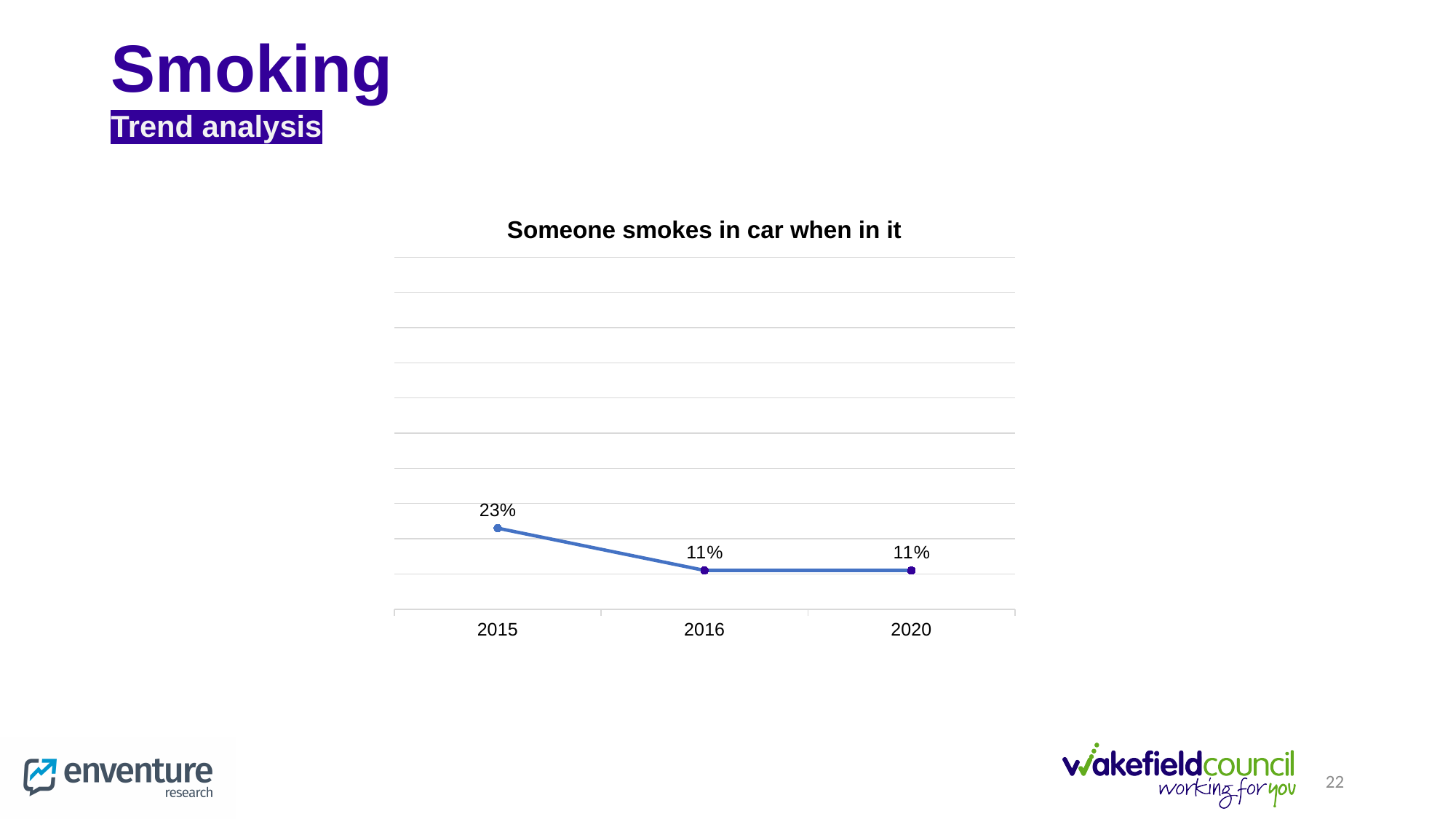
Which year has the highest value in the chart? 2015 Does the value change between 2016 and 2020? No, it stays at 11% Which is larger, the value for 2015 or the value for 2020? 2015 What is the difference between the 2016 value and the 2020 value? 0% What is the value for 2015 in the 'Someone smokes in car when in it' chart? 23% What is the title of the chart? Someone smokes in car when in it What is the difference between the 2015 value and the 2016 value? 12% How many years are plotted on the x axis of the chart? 3 What is the value for 2016 in the chart? 11% What kind of chart is shown on the slide? Line chart What is the value for 2020 in the chart? 11% Does the value rise or fall from 2015 to 2016? Fall